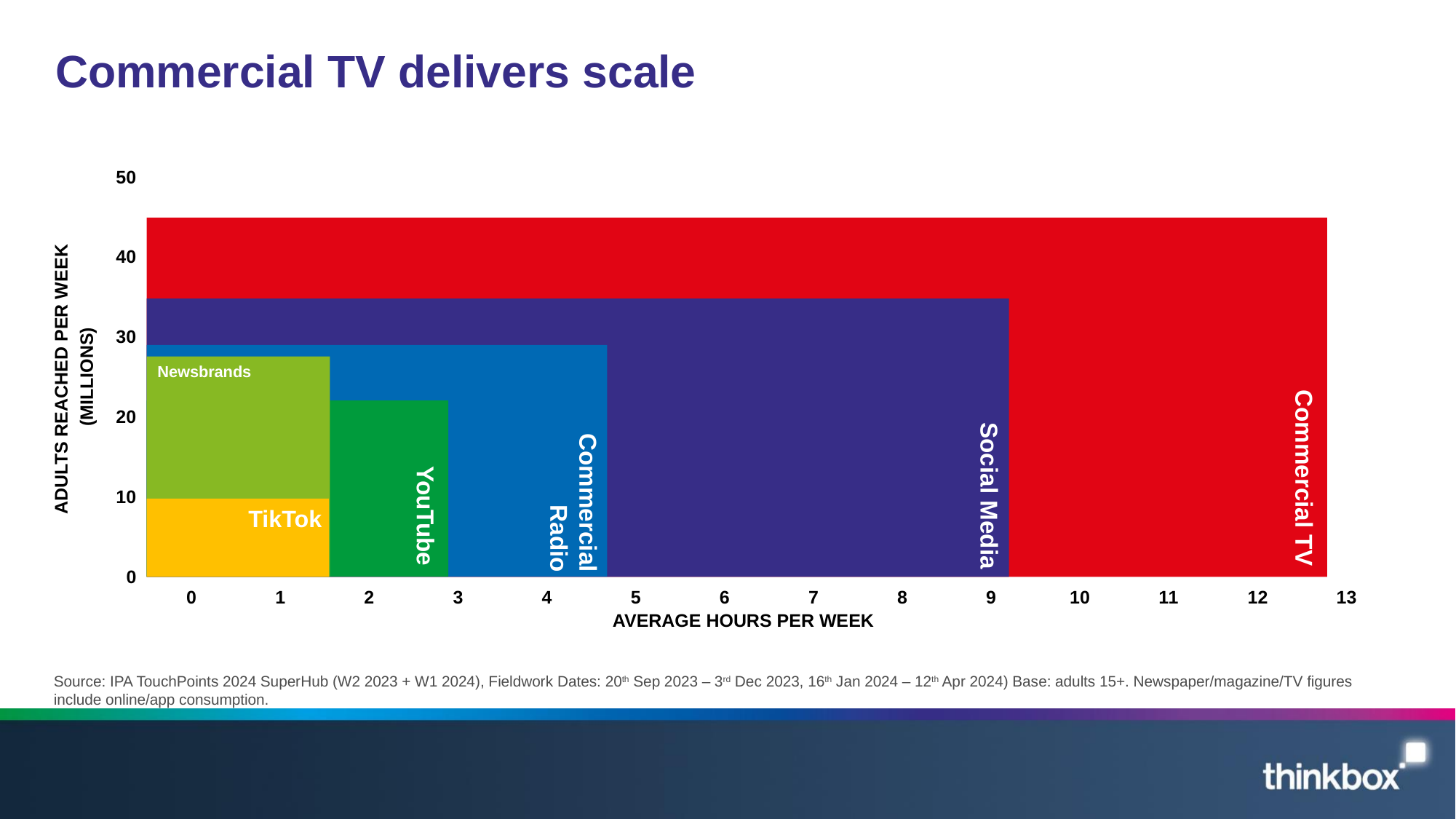
Is the average hours per week for Commercial TV greater or less than 12? greater Is the number of adults reached per week by Social Media greater or less than 30 million? greater Which media category reaches the most adults per week? Commercial TV Which media category reaches the fewest adults per week? TikTok Is the number of adults reached per week by TikTok greater or less than 20 million? less How many media categories are labelled in the chart? 6 What is the label of the x axis of the chart? AVERAGE HOURS PER WEEK What kind of chart is shown on the slide? bar chart What is the title of the chart on the slide? Commercial TV delivers scale Which reaches more adults per week, Social Media or Commercial Radio? Social Media